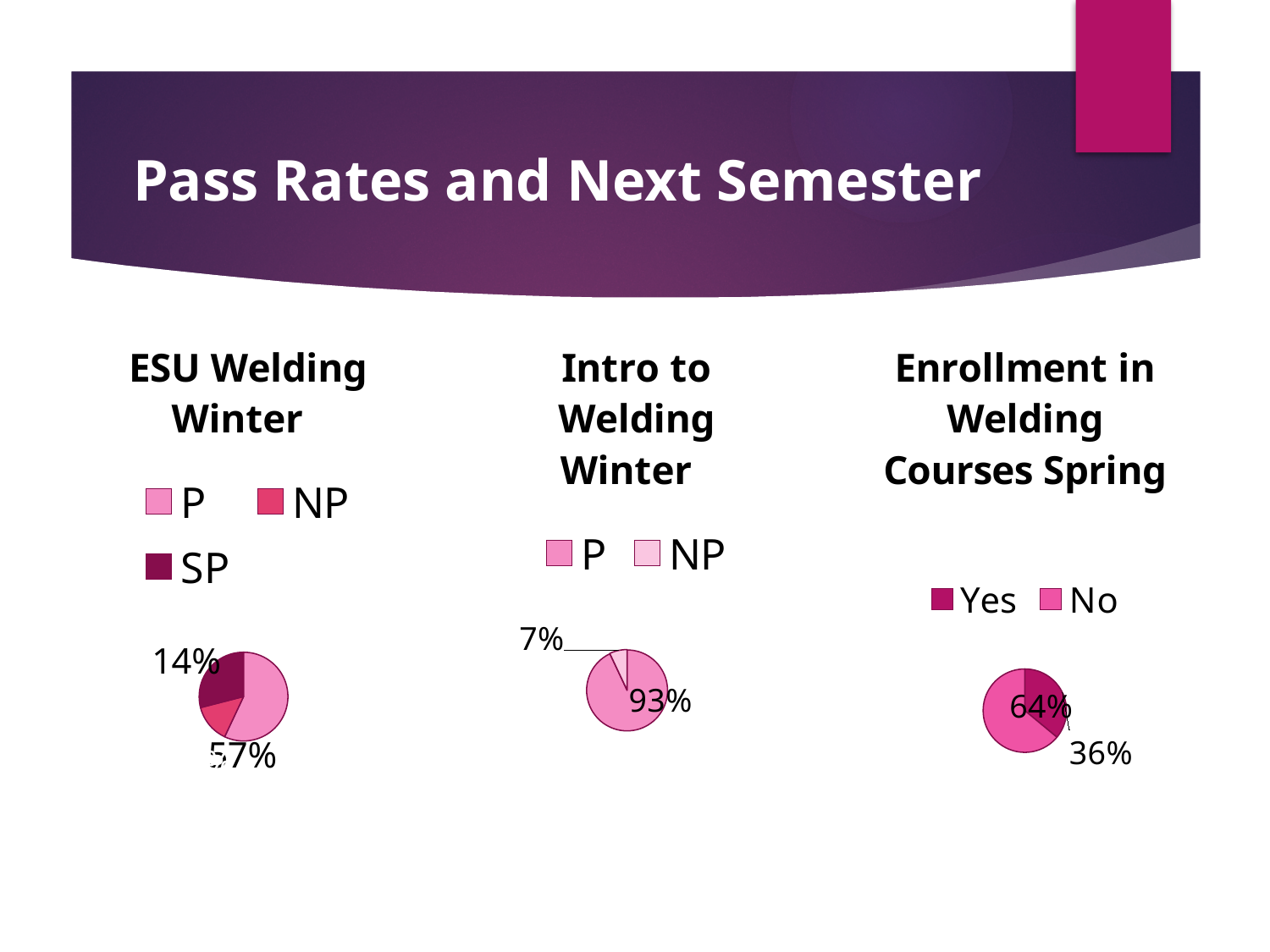
How many entries does the legend of the "Intro to Welding Winter" chart list? 2 How many entries does the legend of the "ESU Welding Winter" chart list? 3 In the "Intro to Welding Winter" chart, which category has the largest slice? P What kind of chart is used for "Intro to Welding Winter"? pie chart In the "Intro to Welding Winter" chart, what percentage is shown for P? 93% In the "Enrollment in Welding Courses Spring" chart, which is larger, Yes or No? No In the "Intro to Welding Winter" chart, what percentage is shown for NP? 7% In the "Intro to Welding Winter" chart, what is the difference between the P and NP percentages? 86% In the "Enrollment in Welding Courses Spring" chart, what percentage is shown for No? 64% In the "Enrollment in Welding Courses Spring" chart, what percentage is shown for Yes? 36% How many pie charts are shown on the slide? 3 In the "ESU Welding Winter" chart, which category has the largest slice? P